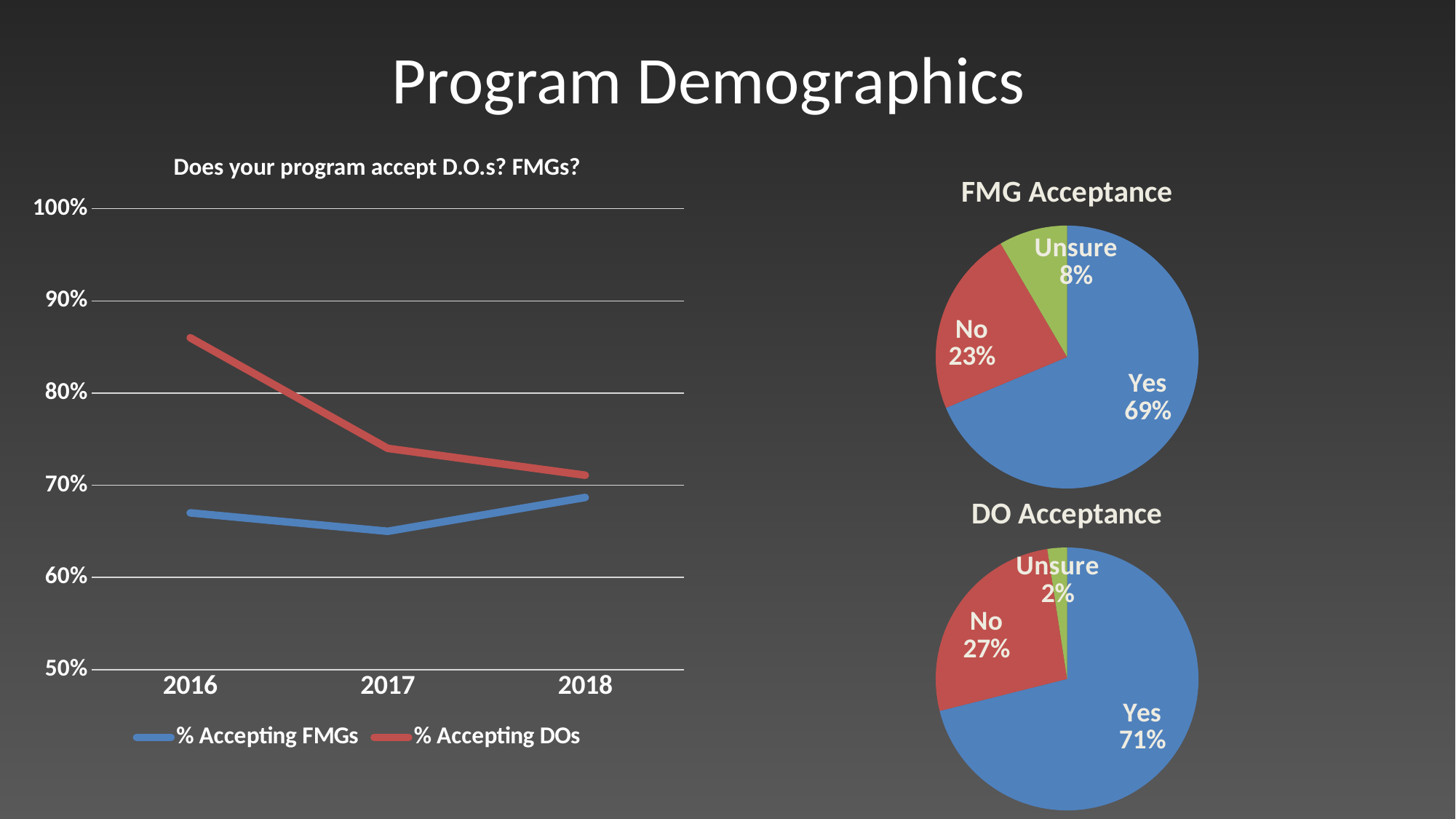
In the line chart 'Does your program accept D.O.s? FMGs?', how many series does the legend list? 2 In the line chart 'Does your program accept D.O.s? FMGs?', is the value for % Accepting DOs in 2016 greater or less than 80%? greater In the 'FMG Acceptance' pie chart, which slice is the smallest? Unsure In the 'FMG Acceptance' pie chart, what share is labelled Yes? 69% In the line chart 'Does your program accept D.O.s? FMGs?', how many years are shown on the x axis? 3 In the 'DO Acceptance' pie chart, what share is labelled No? 27% In the 'DO Acceptance' pie chart, which slice is the largest? Yes What kind of chart is 'DO Acceptance'? pie chart In the line chart 'Does your program accept D.O.s? FMGs?', which series is higher in 2016, % Accepting FMGs or % Accepting DOs? % Accepting DOs In the line chart 'Does your program accept D.O.s? FMGs?', does the % Accepting DOs series rise or fall from 2016 to 2018? fall In the 'FMG Acceptance' pie chart, what is the difference between the Yes and No shares? 46% In the line chart 'Does your program accept D.O.s? FMGs?', is the value for % Accepting FMGs in 2017 greater or less than 70%? less